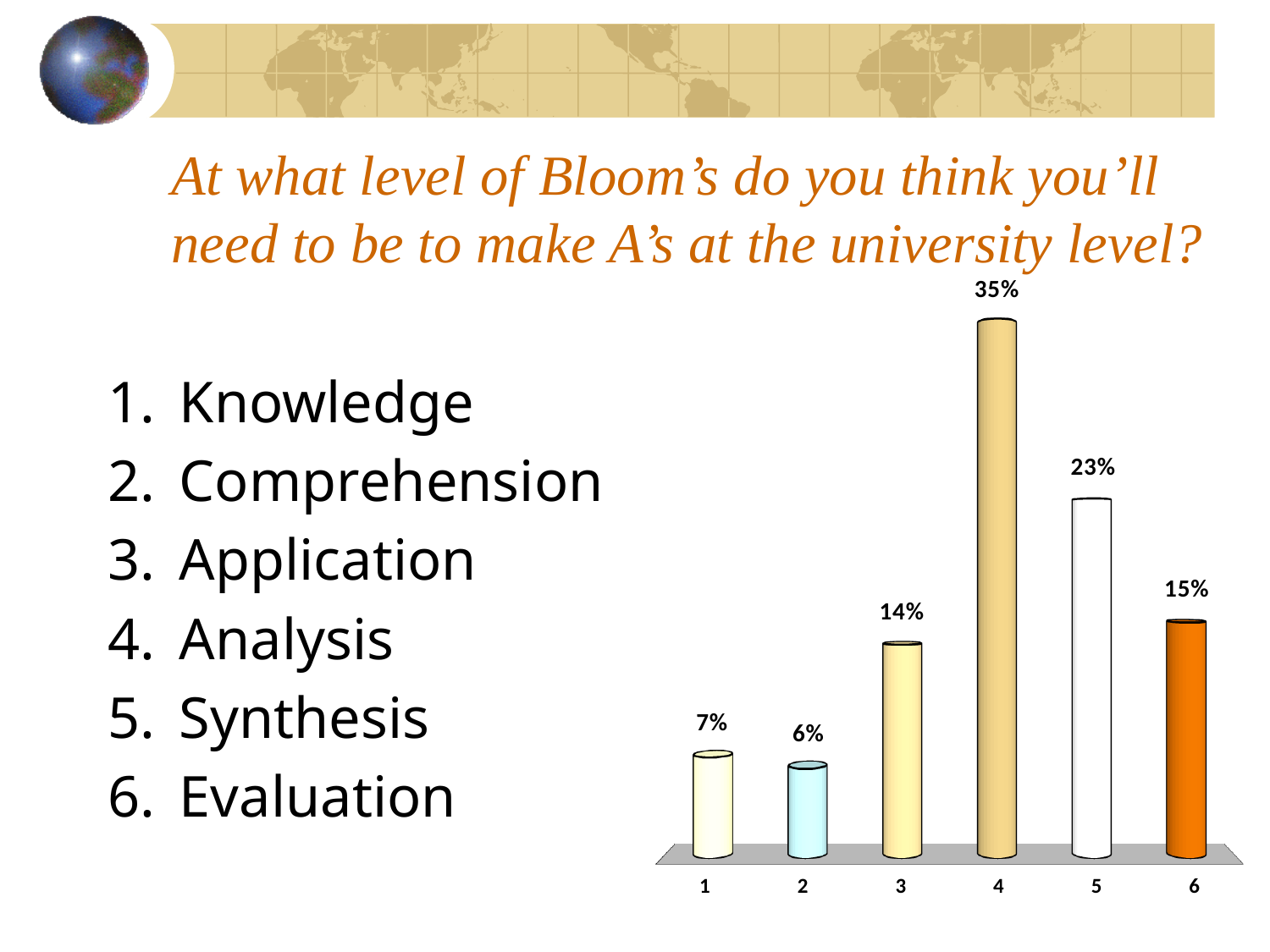
Do the values rise or fall from category 2 to category 4? rise Which is larger, the value for category 5 or the value for category 6? 5 What is the difference between the values for category 4 and category 5? 12% What colour is the bar for category 6? orange What is the value for category 4? 35% What kind of chart is shown on the slide? bar chart What is the difference between the values for category 3 and category 2? 8% Which category has the lowest value? 2 Which category has the highest value? 4 What is the value for category 6? 15% How many categories are shown on the x axis? 6 What is the value for category 1? 7%